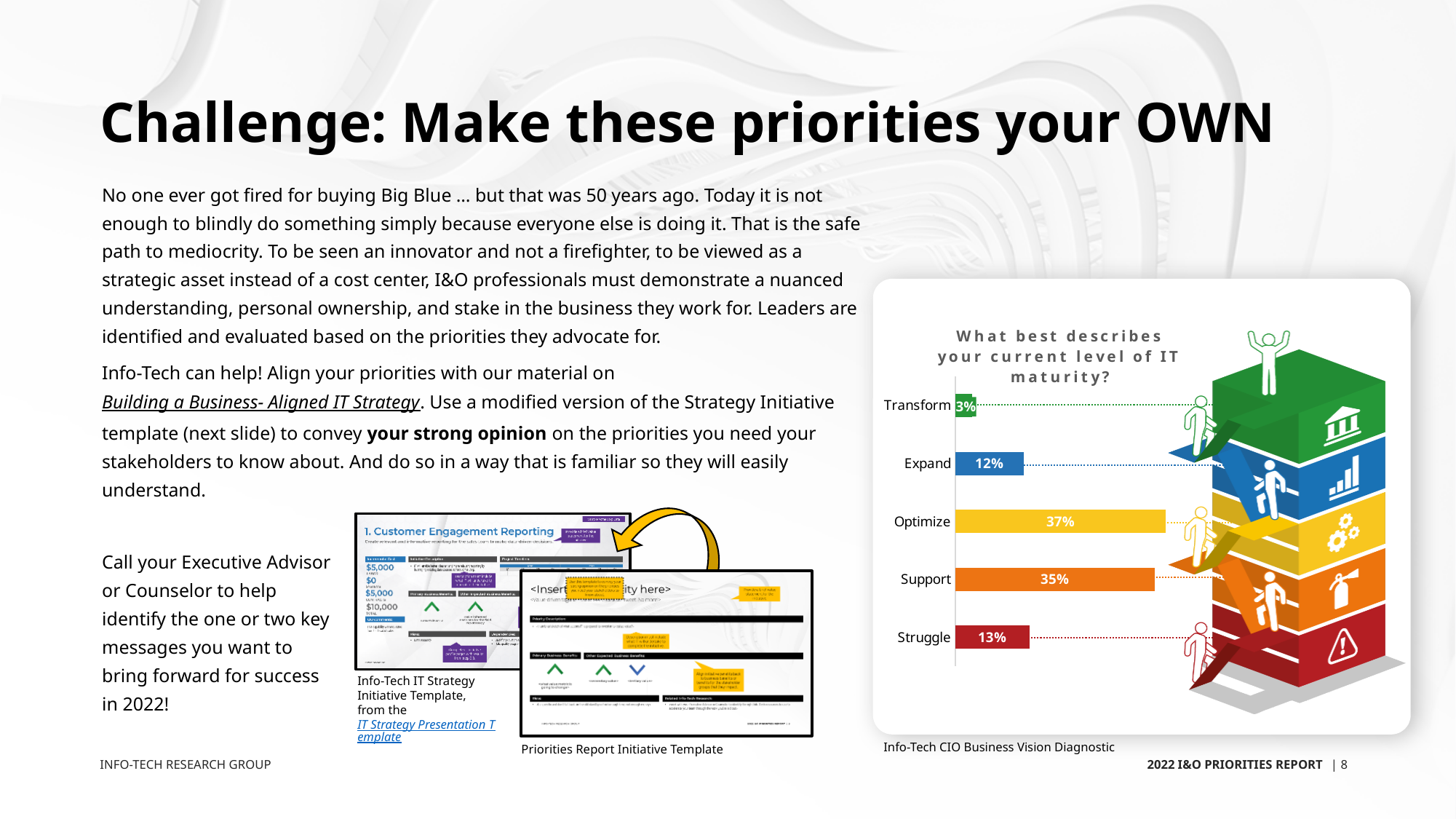
How many categories are shown in the IT maturity chart? 5 What value is shown for "Expand" in the IT maturity chart? 12% In the IT maturity chart, which is larger: the value for Expand or the value for Struggle? Struggle Which category has the highest value in the IT maturity chart? Optimize In the IT maturity chart, what is the difference between the values for Support and Struggle? 22% What value is shown for "Struggle" in the IT maturity chart? 13% In the IT maturity chart, what is the difference between the values for Expand and Transform? 9% What is the title of the chart on the right side of the slide? What best describes your current level of IT maturity? Which category has the lowest value in the IT maturity chart? Transform What type of chart is used to show the IT maturity survey results? Bar chart What percentage of respondents chose "Optimize" in the chart "What best describes your current level of IT maturity?" 37% What value is shown for "Transform" in the IT maturity chart? 3%